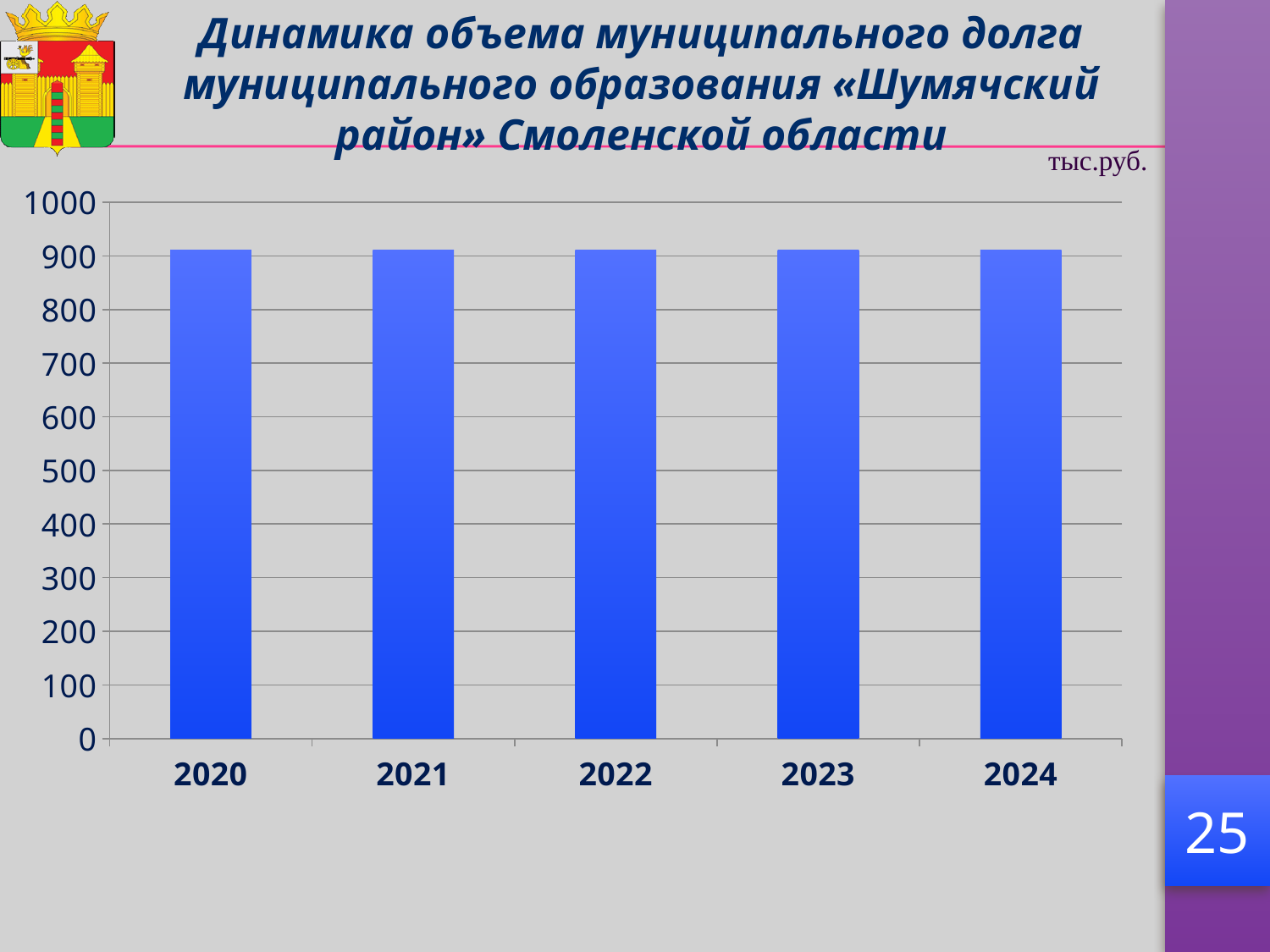
Is the value for 2024 greater or less than 500? greater How many years are shown on the x axis of the chart? 5 Is the value for 2022 greater or less than 1000? less Is the value for 2020 greater or less than 800? greater What is the first year shown on the x axis? 2020 What kind of chart is shown on the slide? bar chart Do the values rise, fall, or stay the same from 2020 to 2024? stay the same What unit is indicated above the chart? тыс.руб.